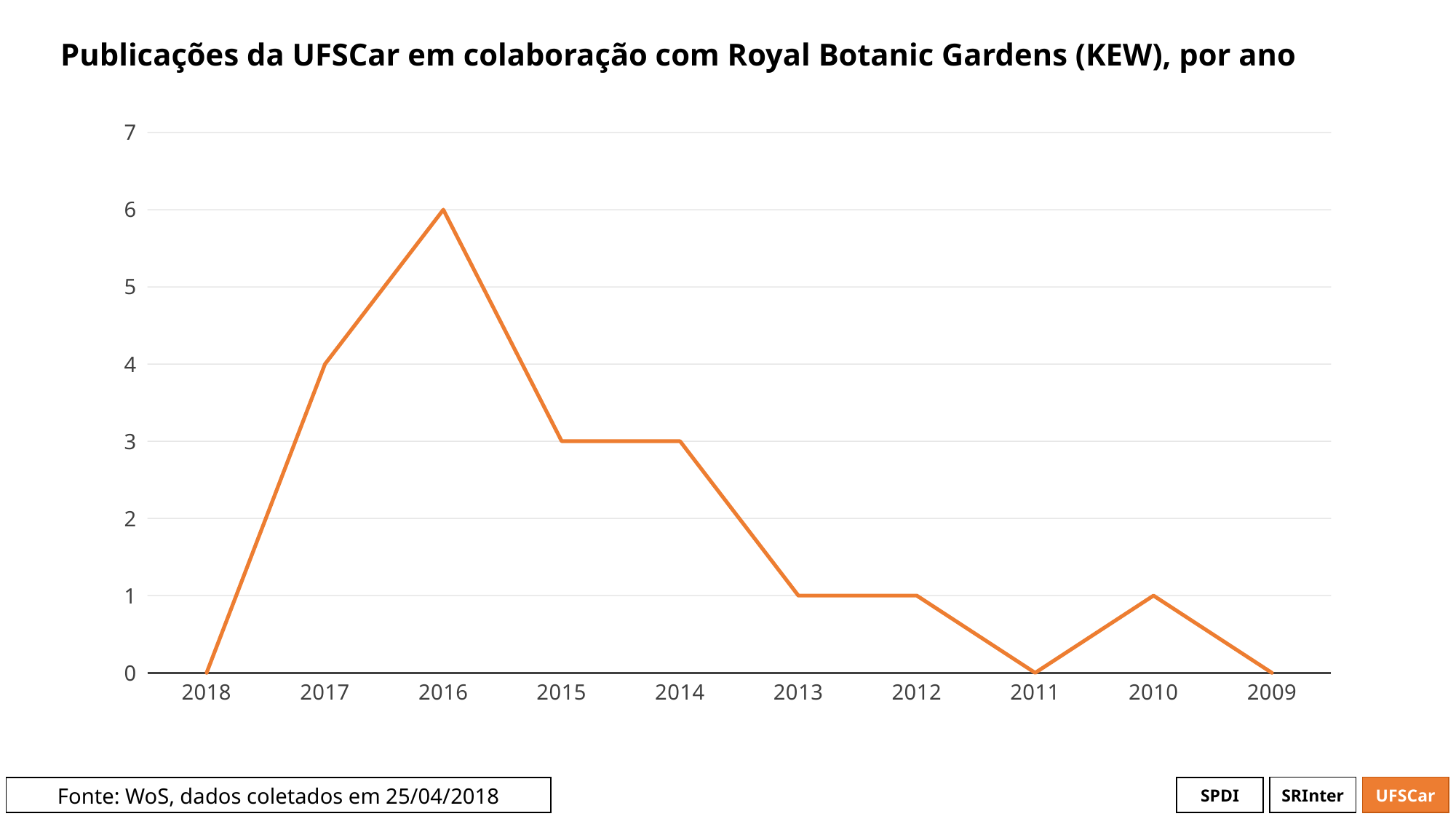
What is the value for 2013? 1 Which year has the highest value? 2016 What is the value for 2016? 6 Which is larger, the value for 2014 or the value for 2012? 2014 What type of chart is shown on the slide? line chart Do the values rise or fall from 2016 to 2013 along the x axis? fall What is the difference between the values for 2016 and 2017? 2 What is the value for 2017? 4 How many years are plotted on the x axis? 10 Is the value for 2016 greater or less than 5? greater What is the title of the chart? Publicações da UFSCar em colaboração com Royal Botanic Gardens (KEW), por ano What is the value for 2015? 3